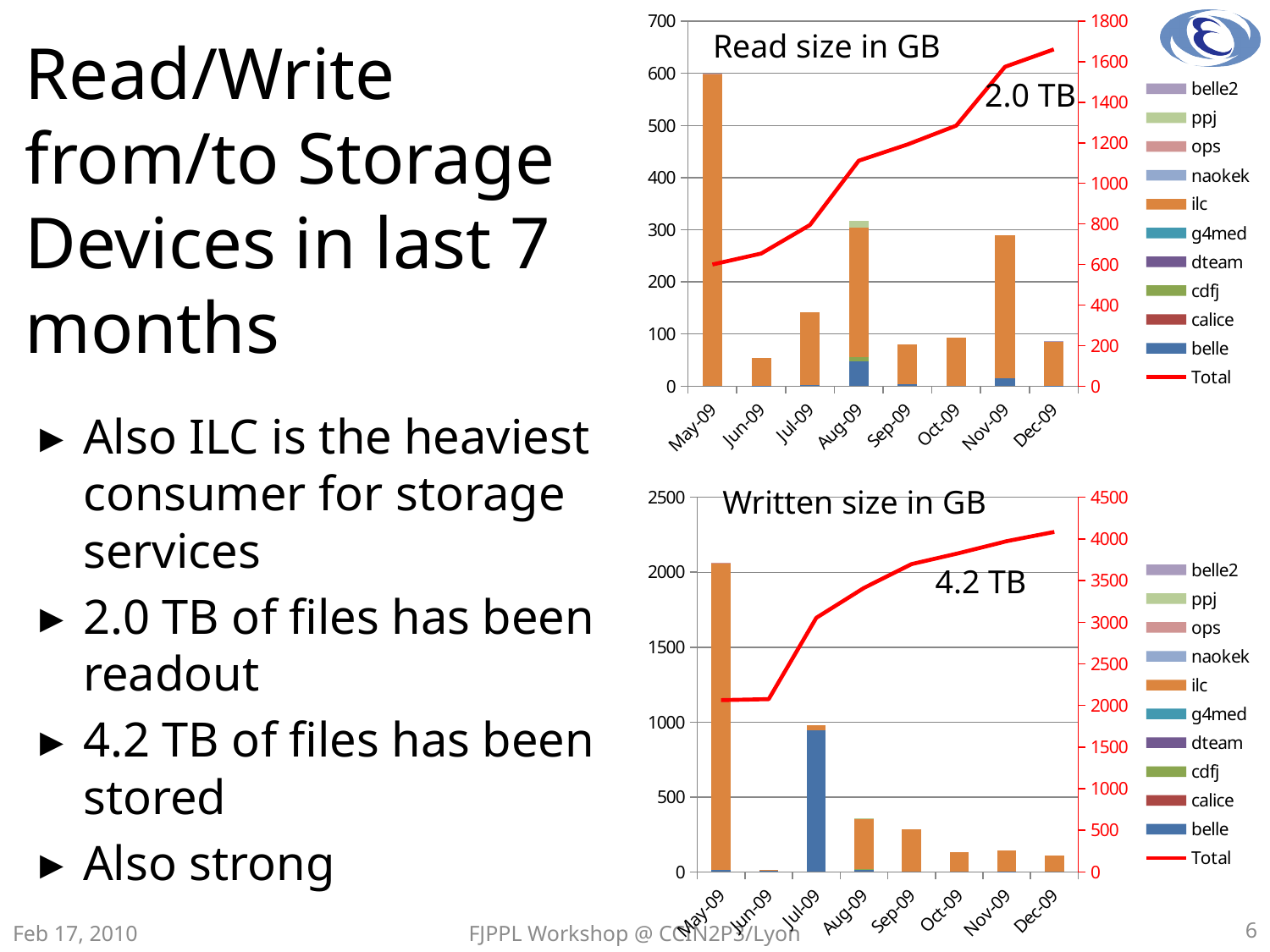
What kind of chart is the 'Read size in GB' chart? bar chart (with a line for Total) How many months are shown on the x axis of the 'Written size in GB' chart? 8 In the 'Written size in GB' chart, which series makes up almost all of the Jul-09 bar? belle In the 'Read size in GB' chart, is the bar for Jun-09 greater or less than 100? less In the 'Read size in GB' chart, which month has the lowest bar? Jun-09 In the 'Read size in GB' chart, is the bar for May-09 greater or less than 500? greater In the 'Written size in GB' chart, which bar is larger, Jul-09 or Aug-09? Jul-09 How many entries does the legend of the 'Read size in GB' chart list? 11 In the 'Read size in GB' chart, which month has the highest bar? May-09 In the 'Read size in GB' chart, does the Total line rise or fall from May-09 to Dec-09? rises In the 'Written size in GB' chart, which month has the highest bar? May-09 In the 'Written size in GB' chart, is the bar for May-09 greater or less than 2000? greater